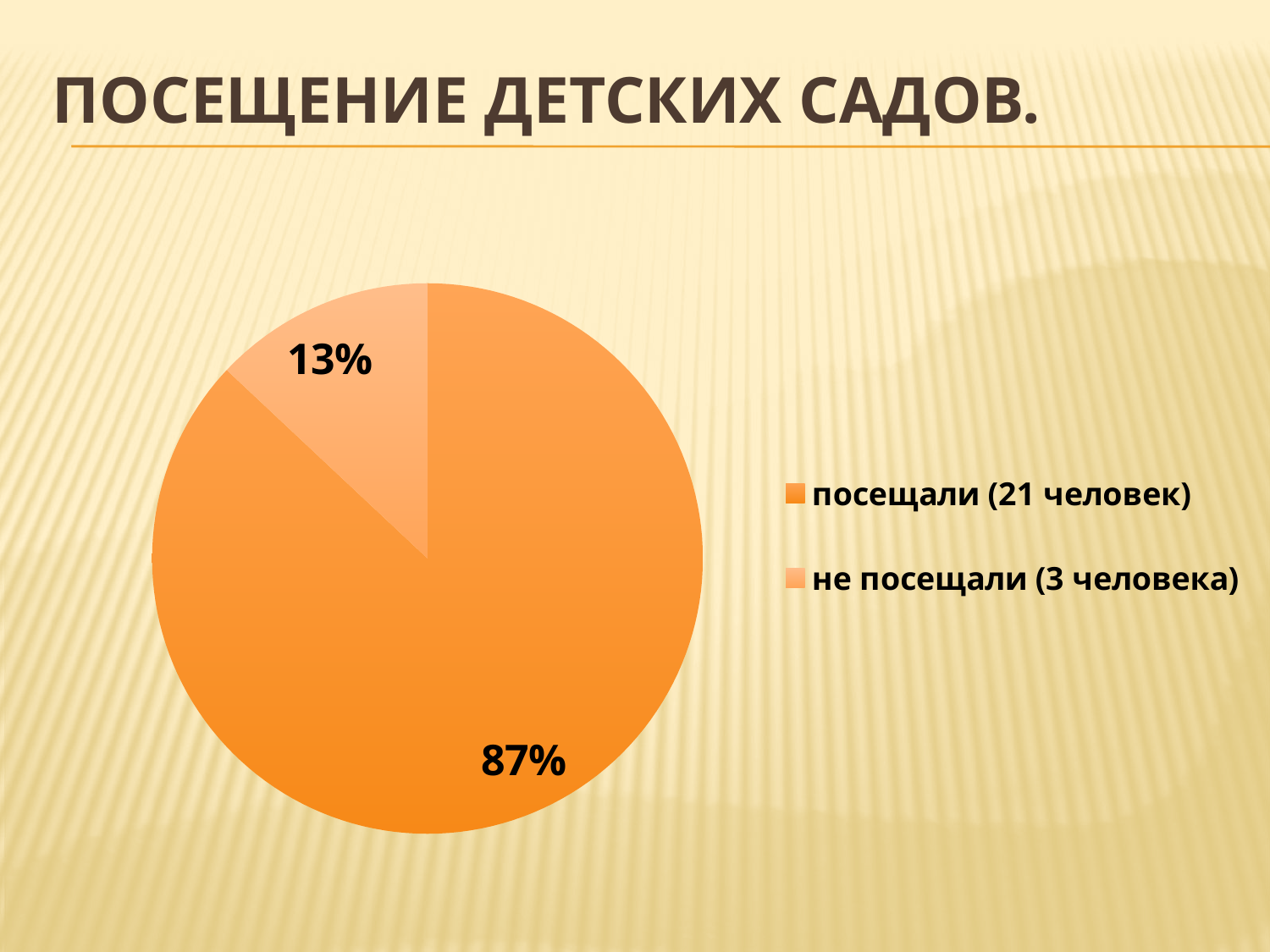
Which is larger: the 'посещали (21 человек)' slice or the 'не посещали (3 человека)' slice? посещали (21 человек) What is the title of the slide containing the chart? ПОСЕЩЕНИЕ ДЕТСКИХ САДОВ. Which slice is the largest in the pie chart? посещали (21 человек) How many entries does the legend list? 2 Which slice is the smallest in the pie chart? не посещали (3 человека) How many people are listed in the legend for the 'не посещали' category? 3 What kind of chart is shown on the slide? pie chart What share of the pie does the slice 'не посещали (3 человека)' represent? 13% What is the difference in percentage points between the 'посещали' slice and the 'не посещали' slice? 74 How many slices does the pie chart have? 2 What share of the pie does the slice 'посещали (21 человек)' represent? 87%